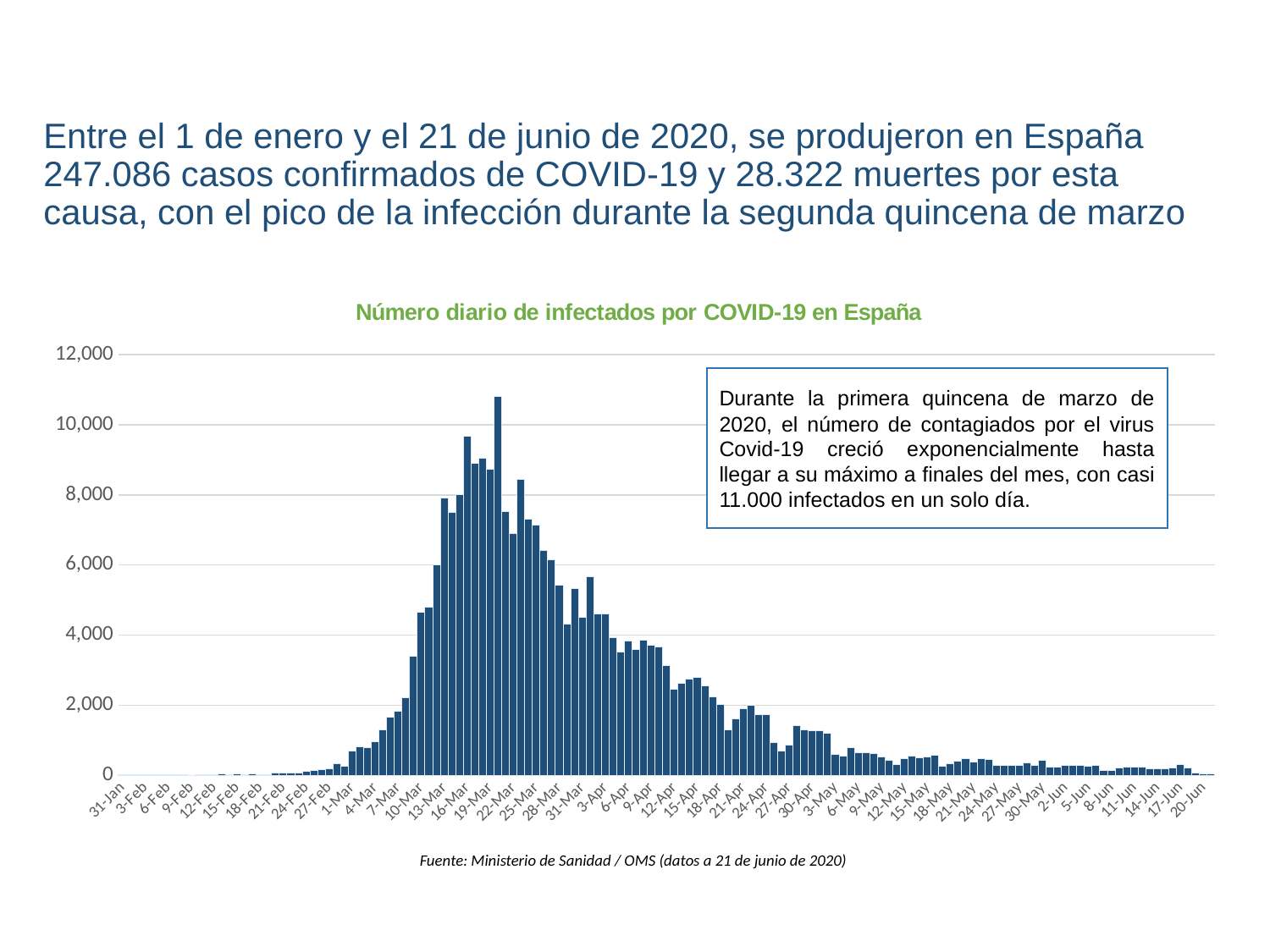
Is the value for 16-Mar greater or less than 8,000? greater Is the value for 30-Apr greater or less than 2,000? less Is the value for 20-Jun greater or less than 2,000? less What is the highest value shown on the vertical axis of the chart? 12,000 What is the title of the chart? Número diario de infectados por COVID-19 en España Which date has the larger value, 16-Mar or 20-Jun? 16-Mar In which month does the chart reach its highest daily value? March What kind of chart is shown on the slide? bar chart Do the daily values rise or fall between 1-Mar and 16-Mar? rise Do the daily values generally rise or fall between 3-Apr and 20-Jun? fall